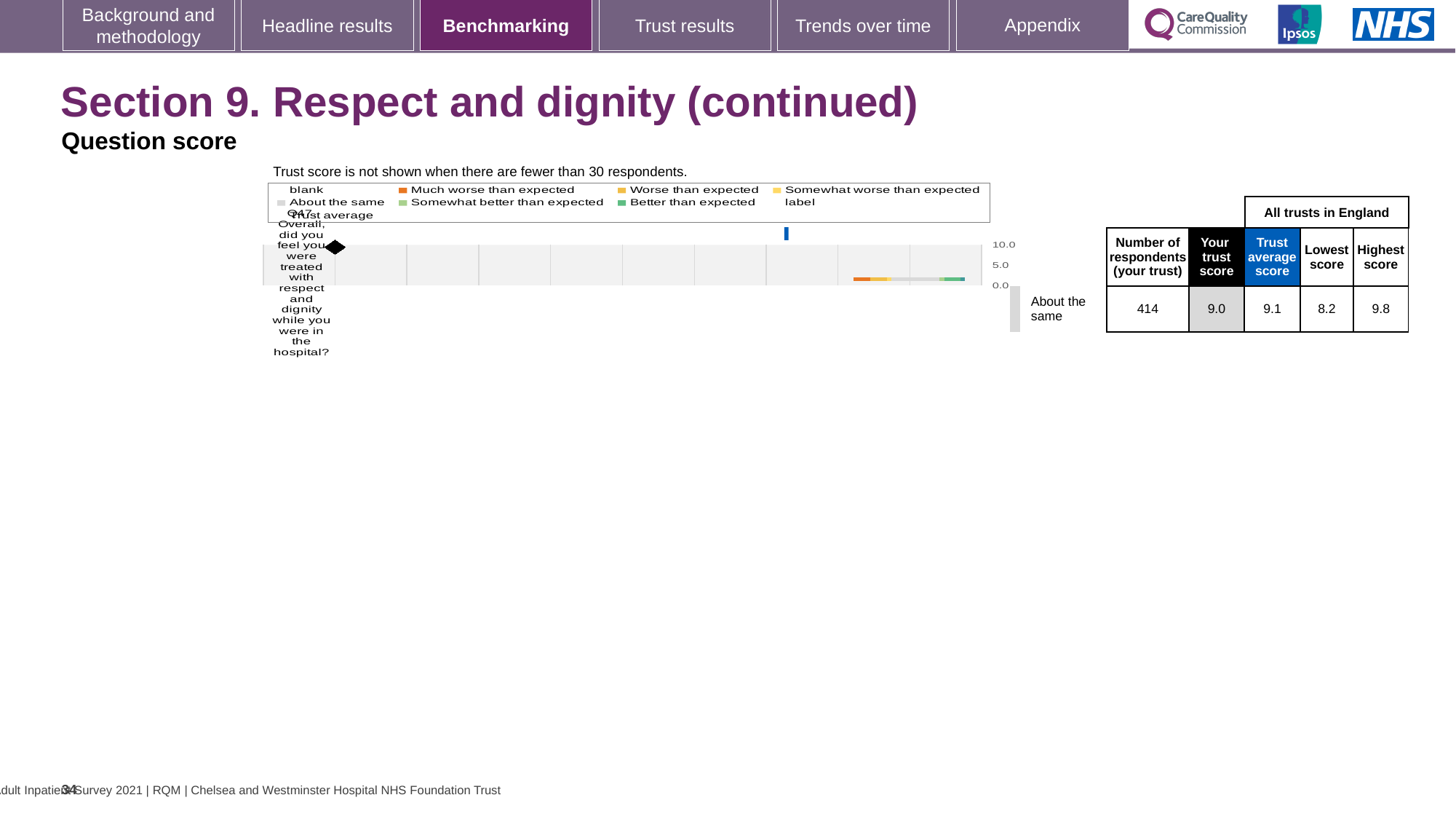
How many questions are plotted on the chart? 1 What is 'Your trust score' for Q47? 9.0 What benchmark category is shown for Q47 next to the chart? About the same What kind of chart is shown on the slide? bar chart What is the number of respondents (your trust) for Q47? 414 What note is printed above the chart about when the trust score is not shown? Trust score is not shown when there are fewer than 30 respondents. What is the difference between the highest score and the lowest score for Q47? 1.6 What is the trust average score for all trusts in England for Q47? 9.1 What colour represents 'Much worse than expected' in the chart legend? orange What is the highest score among all trusts in England for Q47? 9.8 Which question is plotted on the chart? Q47 What is the lowest score among all trusts in England for Q47? 8.2